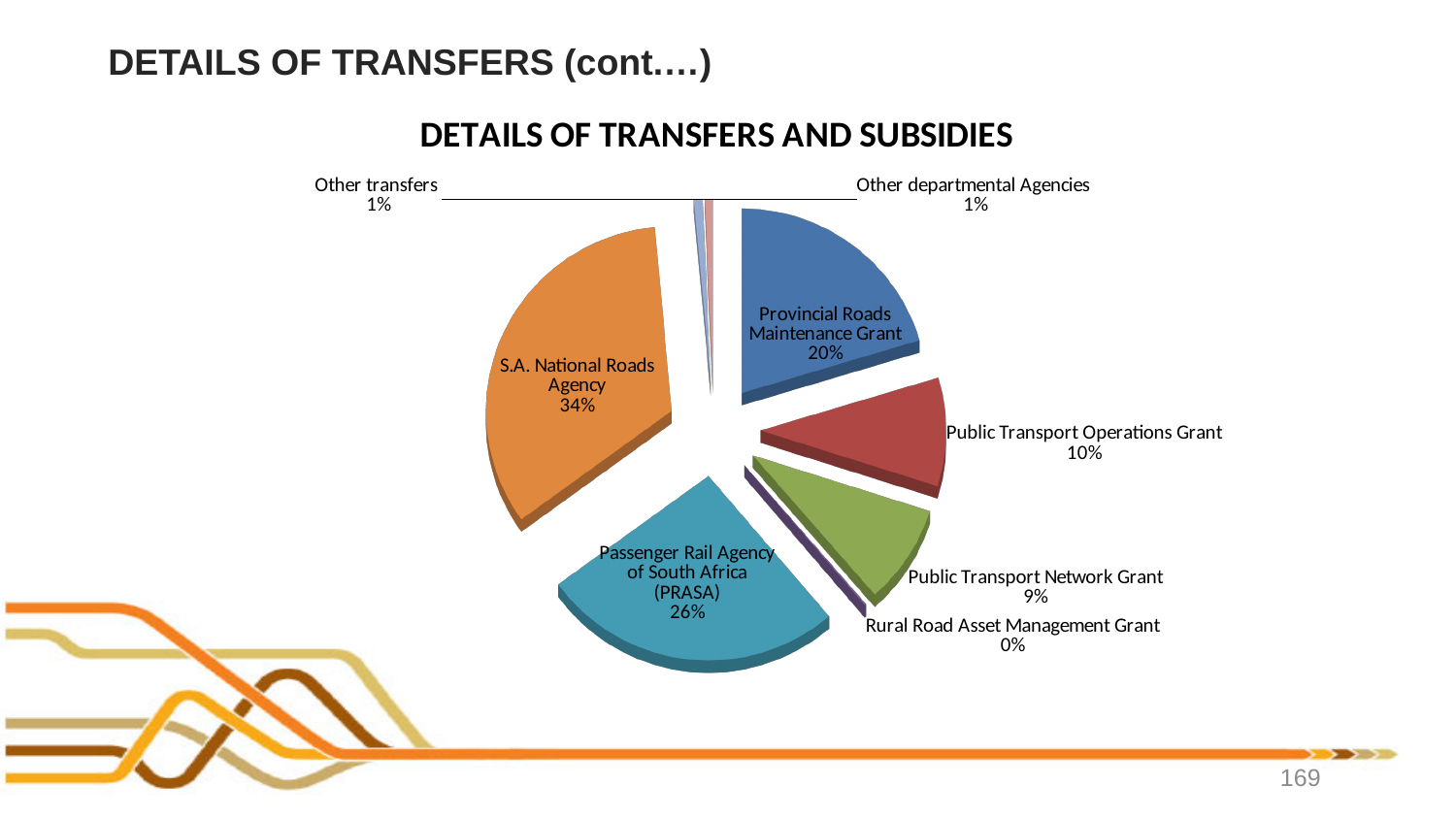
What percentage is shown for the Passenger Rail Agency of South Africa (PRASA)? 26% What is the difference in percentage points between the S.A. National Roads Agency and the Passenger Rail Agency of South Africa (PRASA)? 8% What is the chart's title? DETAILS OF TRANSFERS AND SUBSIDIES What percentage is shown for the Rural Road Asset Management Grant? 0% What percentage is shown for the Public Transport Network Grant? 9% What share of the pie does the S.A. National Roads Agency have? 34% Which is larger, the Provincial Roads Maintenance Grant or the Public Transport Operations Grant? Provincial Roads Maintenance Grant What percentage is shown for the Provincial Roads Maintenance Grant? 20% What kind of chart is shown on the slide? Pie chart Which category has the largest share of the pie? S.A. National Roads Agency Which category has the smallest share of the pie? Rural Road Asset Management Grant What percentage is shown for the Public Transport Operations Grant? 10%